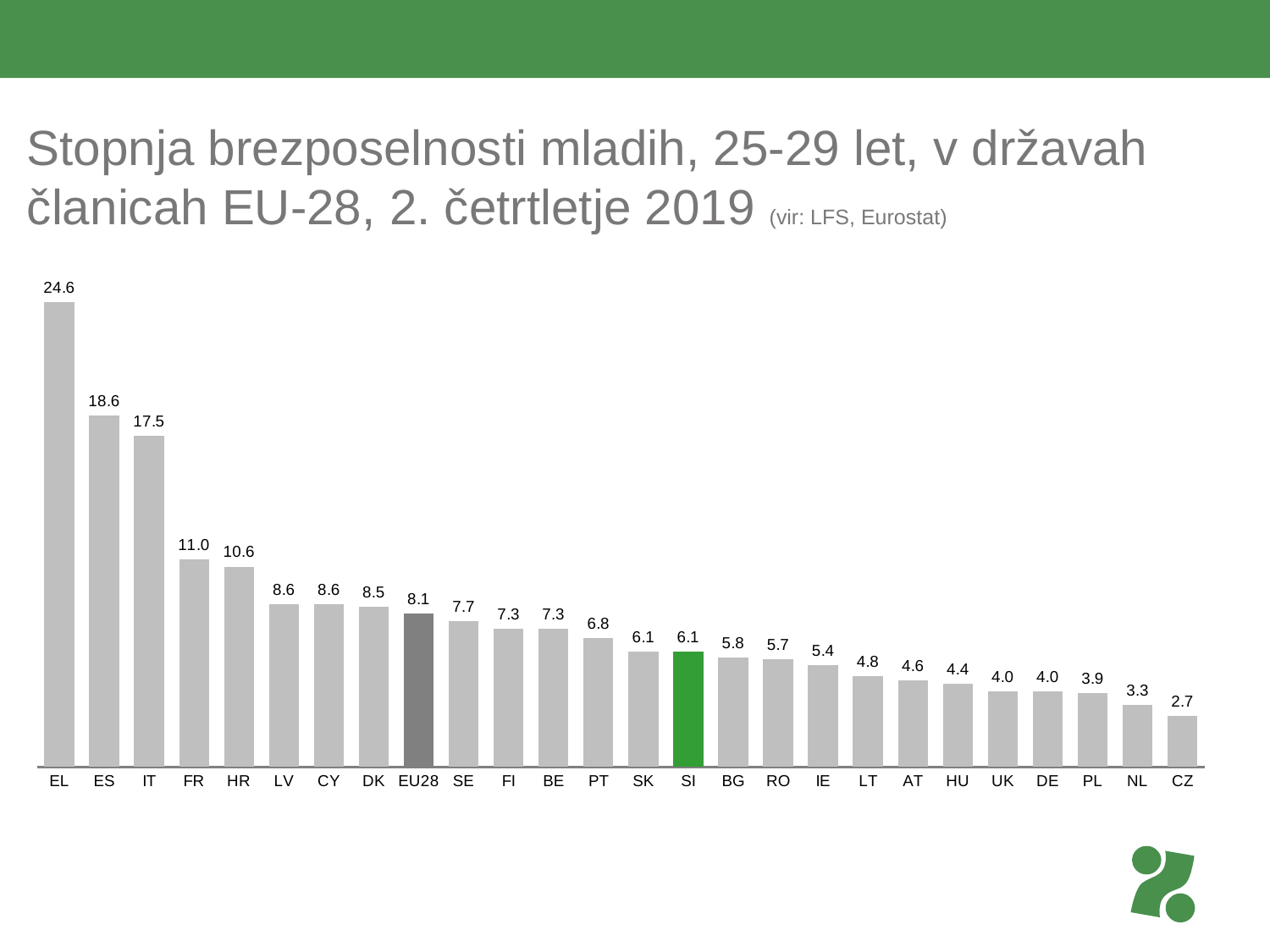
What is the value for FR? 11.0 Do the values rise or fall from left to right along the x axis? fall How many bars are shown in the chart? 26 Which country has the lowest value? CZ Which bar is coloured green? SI What is the difference between the values for EL and ES? 6.0 What is the value for EU28? 8.1 Which is larger, the value for IT or the value for HR? IT What kind of chart is shown on the slide? bar chart What is the value for SI? 6.1 Which country has the highest value? EL What is the difference between the values for EU28 and SI? 2.0